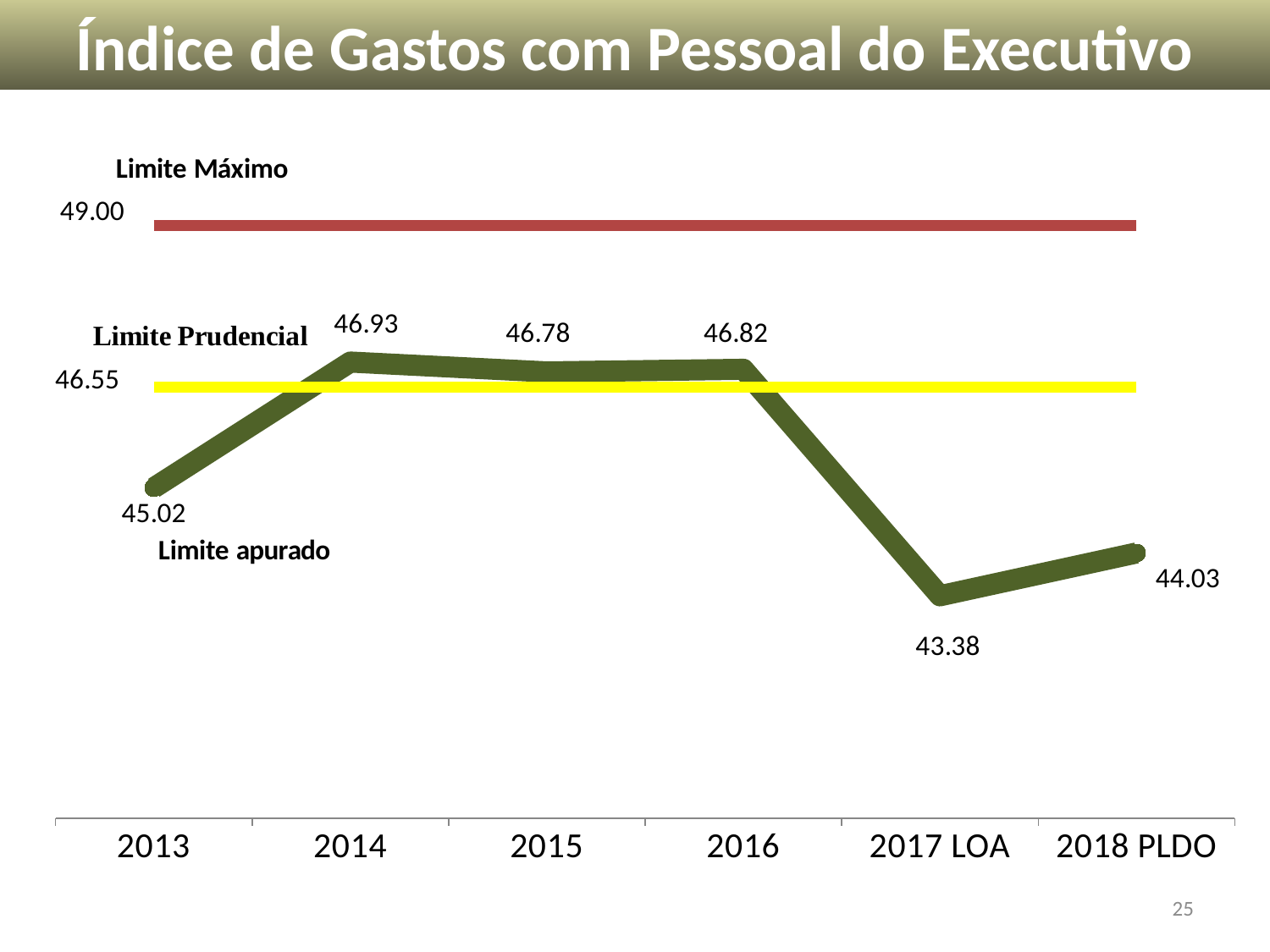
How many years are shown on the x axis? 6 Which is larger, the Limite apurado for 2016 or for 2015? 2016 What is the value of Limite apurado for 2014? 46.93 What is the title of the chart? Índice de Gastos com Pessoal do Executivo What kind of chart is shown on the slide? line chart In which year is the Limite apurado highest? 2014 In which year is the Limite apurado lowest? 2017 LOA What value is shown for the Limite Máximo line? 49.00 What is the value of Limite apurado for 2017 LOA? 43.38 What is the value of Limite apurado for 2018 PLDO? 44.03 What value is shown for the Limite Prudencial line? 46.55 What is the difference between the Limite apurado for 2014 and for 2013? 1.91